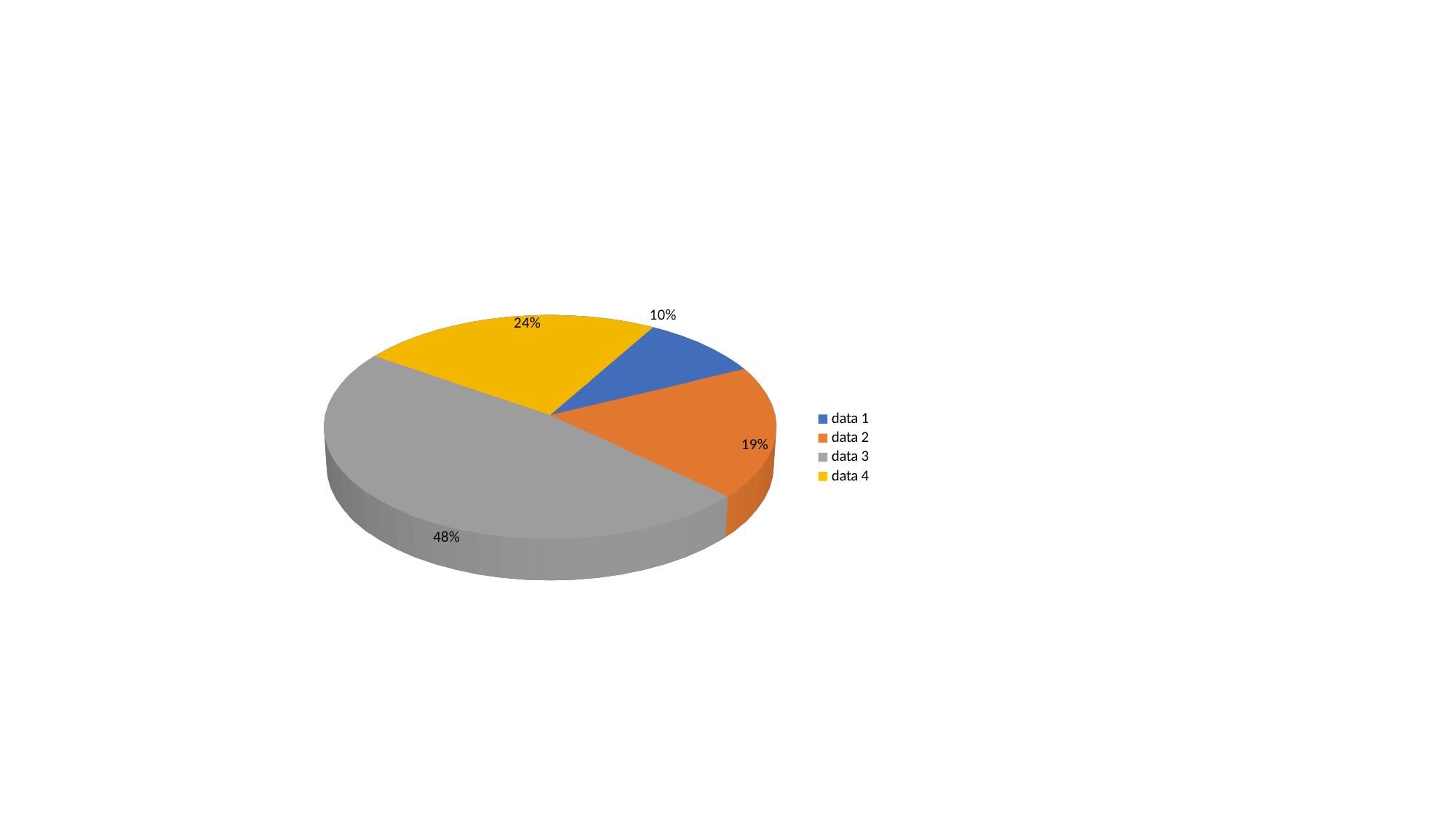
Which slice is larger, data 2 or data 4? data 4 How many categories does the pie chart have? 4 What percentage does the data 4 slice represent? 24% What percentage does the data 3 slice represent? 48% What is the combined share of data 1 and data 2? 29% What kind of chart is shown on the slide? pie chart Which category has the largest slice of the pie? data 3 What colour is the data 3 slice? grey What is the difference in percentage points between the data 3 and data 4 slices? 24 What percentage does the data 2 slice represent? 19% Which category has the smallest slice of the pie? data 1 What percentage does the data 1 slice represent? 10%